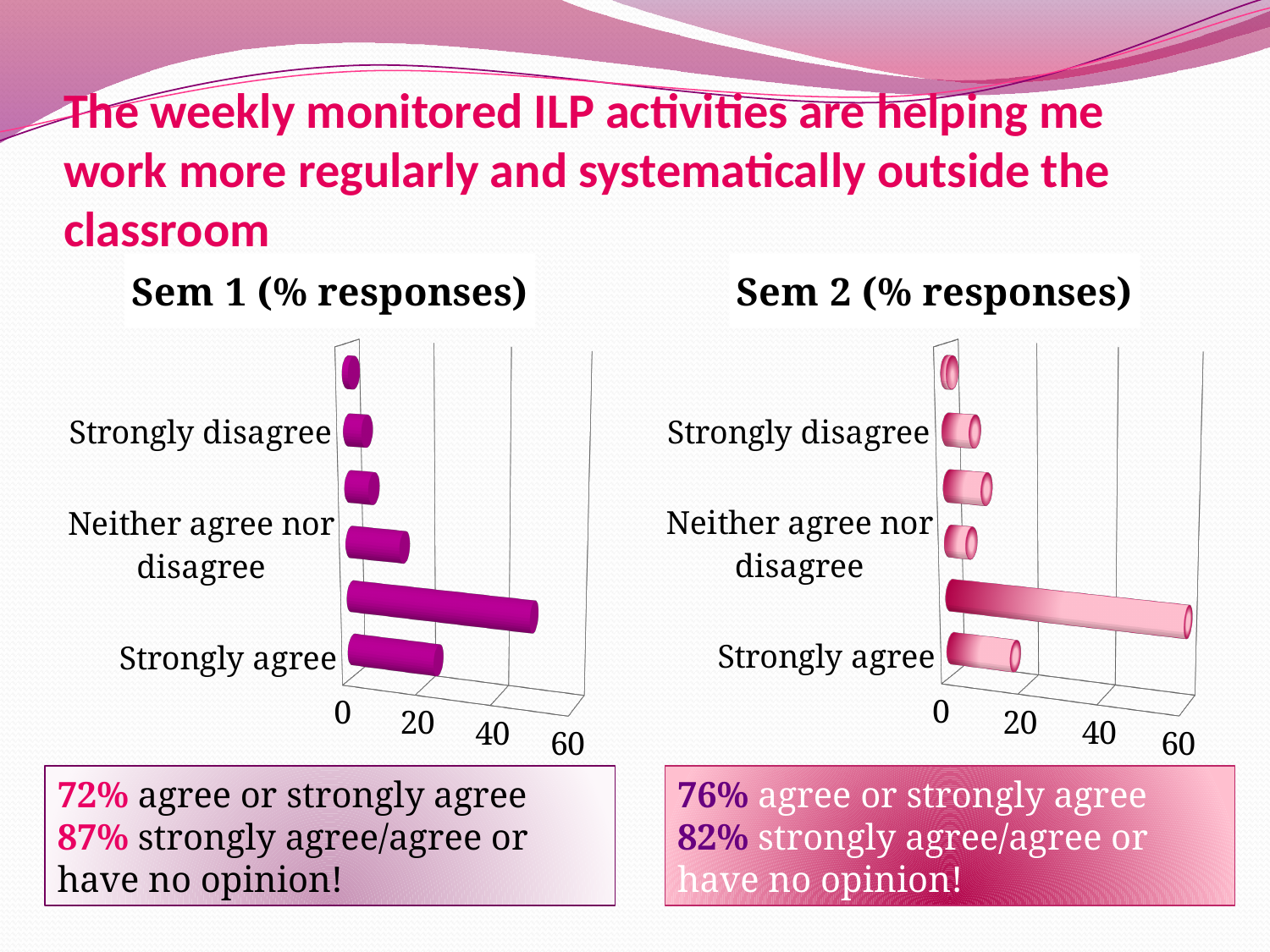
In the Sem 2 (% responses) chart, is the value for Strongly disagree greater or less than 20? less In the Sem 2 (% responses) chart, which is larger, Strongly agree or Neither agree nor disagree? Strongly agree In the Sem 2 (% responses) chart, is the value for Neither agree nor disagree greater or less than 20? less What kind of chart is the Sem 1 (% responses) chart? bar chart What is the highest tick value shown on the value axis of the Sem 2 (% responses) chart? 60 How many bars are plotted in the Sem 2 (% responses) chart? 6 In the Sem 1 (% responses) chart, is the value for Strongly agree greater or less than 40? less Is the Strongly agree bar longer in the Sem 1 (% responses) chart or the Sem 2 (% responses) chart? Sem 1 (% responses) In the Sem 1 (% responses) chart, which is larger, Strongly agree or Strongly disagree? Strongly agree